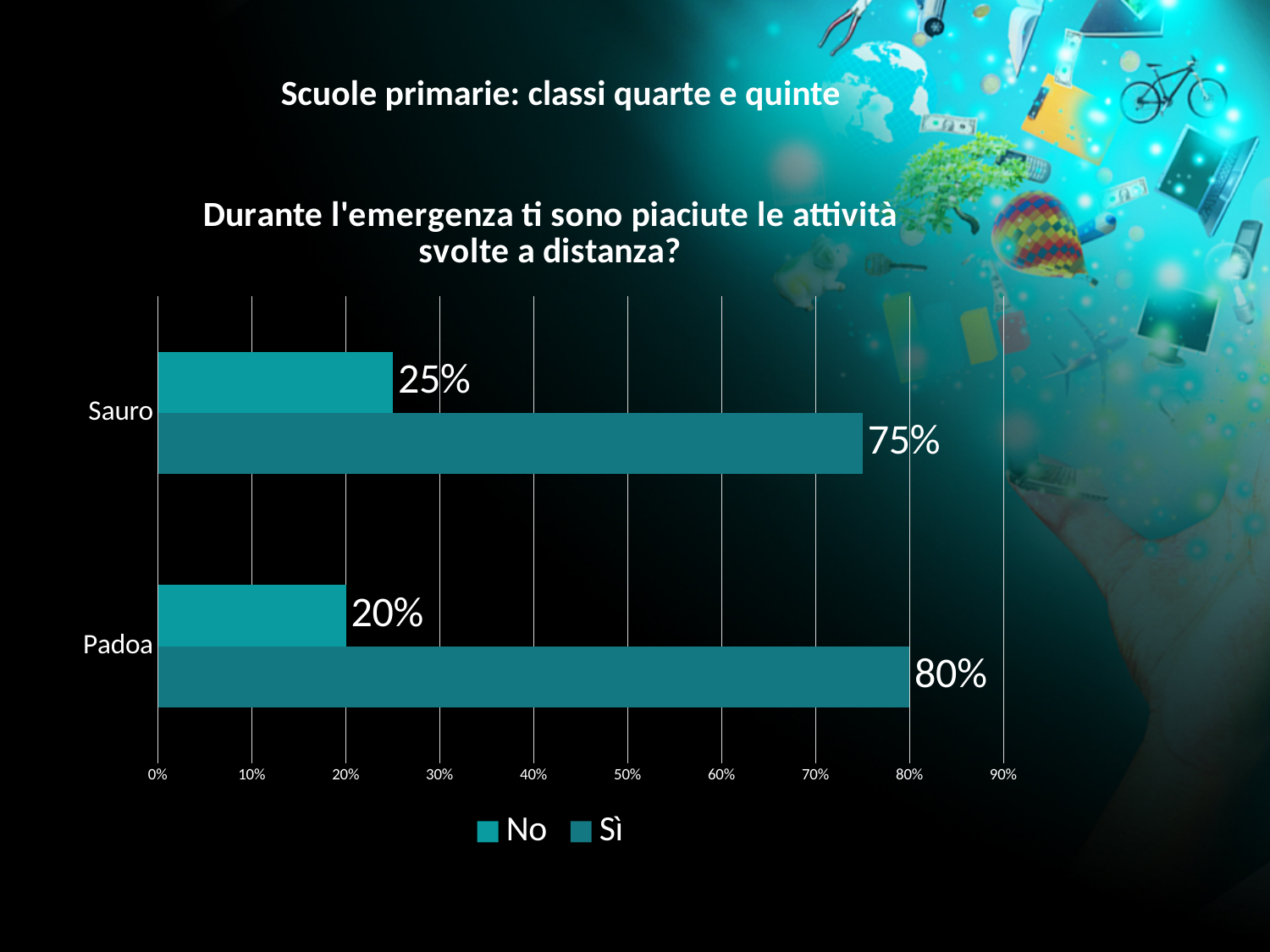
Which school has the higher "Sì" value? Padoa What is the difference between the "Sì" and "No" values for Sauro? 50% What kind of chart is shown on the slide? bar chart What is the value for "Sì" for Padoa? 80% What is the value for "No" for Padoa? 20% How many schools (categories) are shown on the chart? 2 What is the value for "Sì" for Sauro? 75% Is the "No" value for Sauro larger or smaller than the "No" value for Padoa? larger How many series does the legend list? 2 What is the value for "No" for Sauro? 25% Which school has the lower "No" value? Padoa What are the two entries in the chart legend? No and Sì